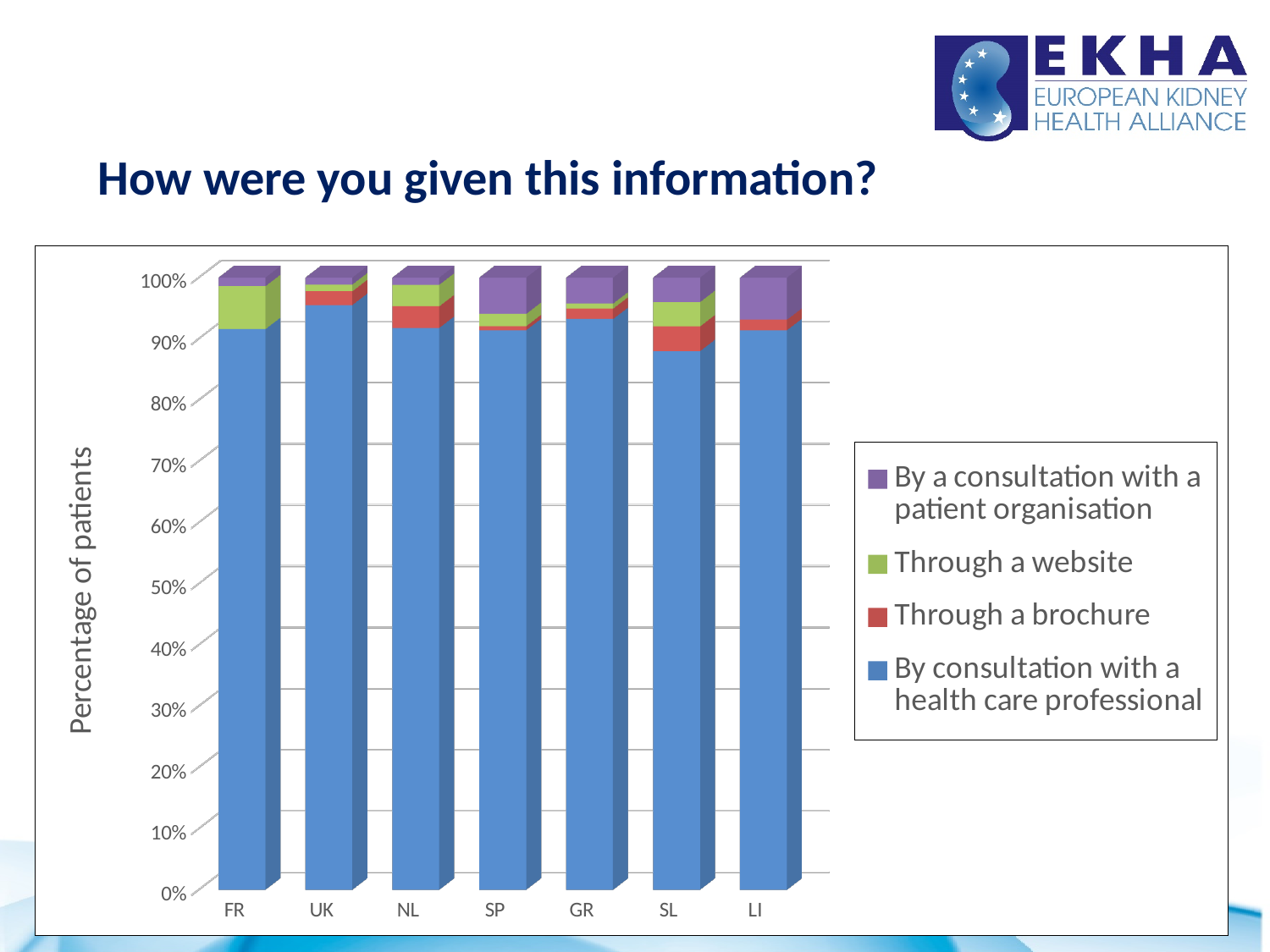
How many countries are shown along the x axis of the chart? 7 Is the share of patients informed by consultation with a health care professional in the UK greater or less than 90%? greater Is the share of patients informed by consultation with a health care professional in SL greater or less than 90%? less Is the share of patients informed by consultation with a health care professional in GR greater or less than 80%? greater What is the label of the vertical axis of the chart? Percentage of patients Which country has the largest share of patients informed by consultation with a health care professional? UK Which is larger: the share of patients informed by consultation with a health care professional in the UK or in SL? UK What is the title of the chart on the slide? How were you given this information? Which country has the smallest share of patients informed by consultation with a health care professional? SL What does each stacked bar in the chart total? 100% How many series does the chart's legend list? 4 What kind of chart is shown on the slide? Stacked bar chart